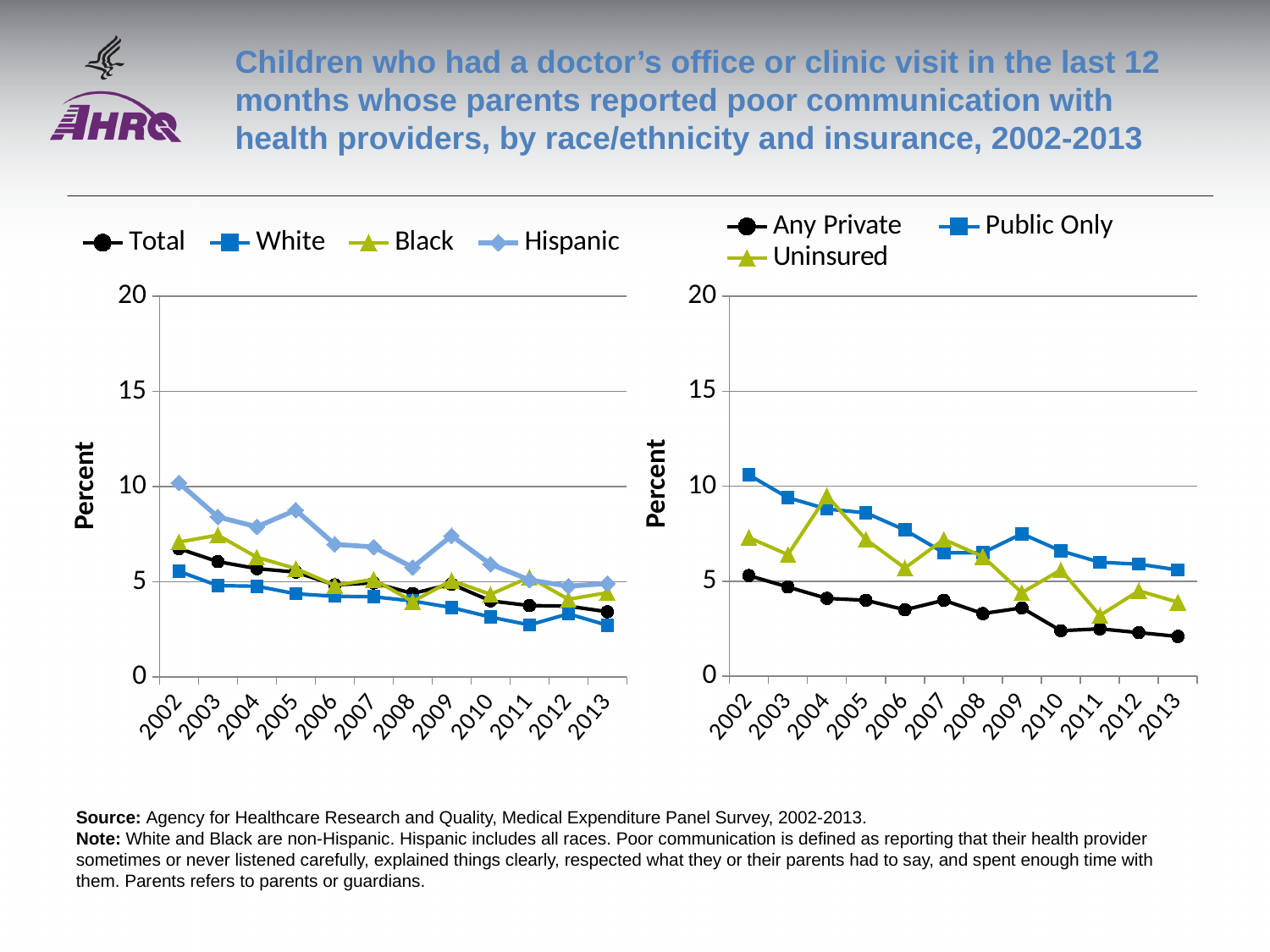
In the right chart, is the value for Public Only in 2002 greater or less than 5? greater What kind of chart is the left chart (Total, White, Black, Hispanic)? line chart What is the label on the y axis of the left chart? Percent In the right chart, does the Any Private line generally rise or fall from 2002 to 2013? fall How many series does the legend of the right chart list? 3 How many series does the legend of the left chart list? 4 In the right chart, which is larger in 2002: Public Only or Any Private? Public Only In the left chart, does the Hispanic line generally rise or fall from 2002 to 2013? fall In the right chart, is the value for Any Private in 2013 greater or less than 5? less How many years are plotted along the x axis of the right chart? 12 In the left chart, which series has the highest value in 2002? Hispanic In the right chart, which series has the lowest value in 2013? Any Private